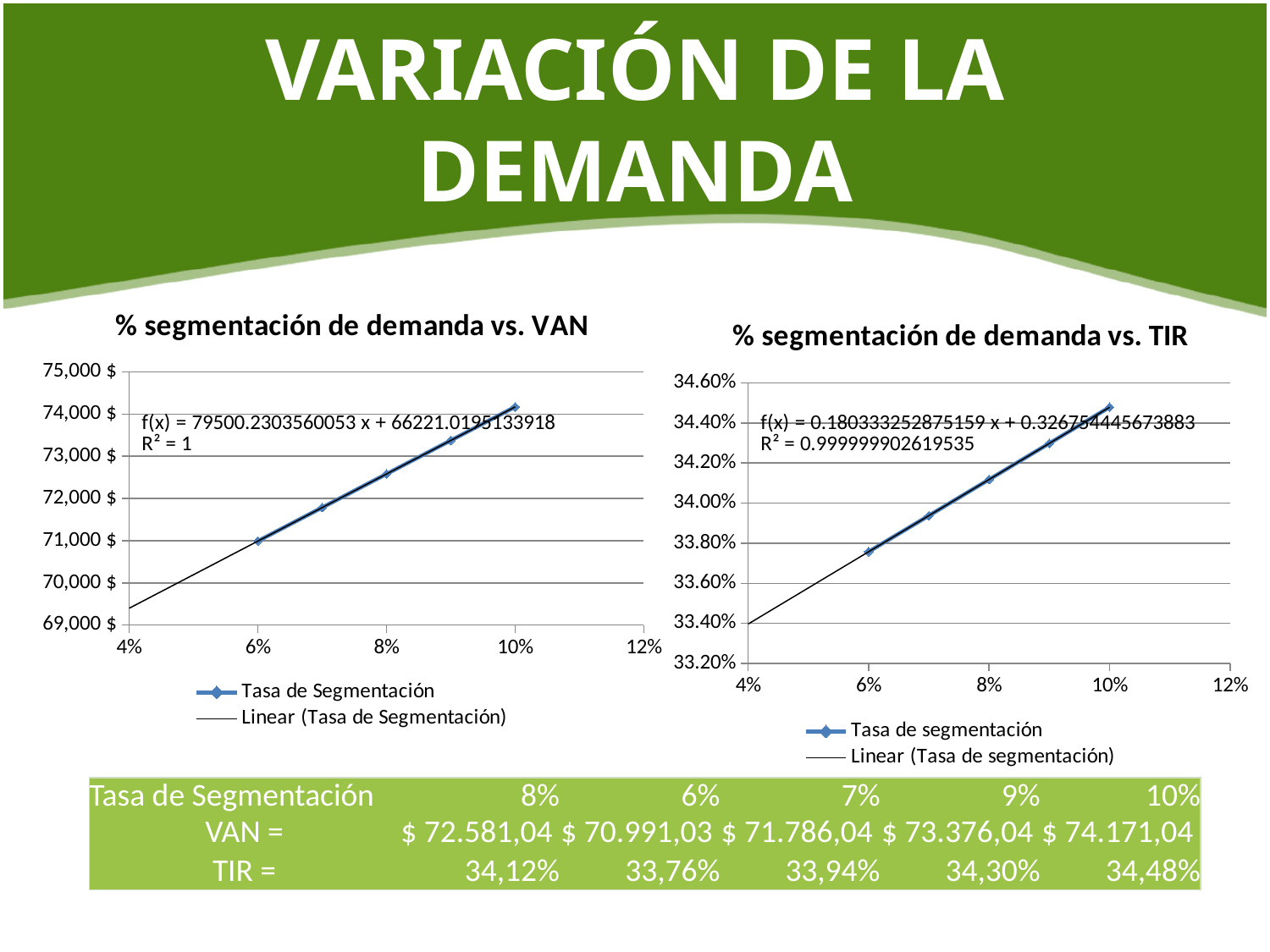
In the '% segmentación de demanda vs. VAN' chart, at which segmentation rate is the VAN highest? 10% In the '% segmentación de demanda vs. VAN' chart, is the value at 7% greater or less than 72,000 $? less In the '% segmentación de demanda vs. VAN' chart, is the value at 9% greater or less than 73,000 $? greater According to the table below the charts, what is the TIR for a Tasa de Segmentación of 10%? 34,48% In the '% segmentación de demanda vs. TIR' chart, at which segmentation rate is the TIR lowest? 6% In the '% segmentación de demanda vs. VAN' chart, do the values rise or fall as the segmentation rate increases along the x axis? rise What kind of chart is the '% segmentación de demanda vs. VAN' chart? line chart What R² value is shown on the '% segmentación de demanda vs. VAN' chart? R² = 1 How many entries does the legend of the '% segmentación de demanda vs. TIR' chart list? 2 In the '% segmentación de demanda vs. VAN' chart, how many data points are plotted for Tasa de Segmentación? 5 In the '% segmentación de demanda vs. TIR' chart, is the value at 8% greater or less than 34.00%? greater According to the table below the charts, what is the VAN for a Tasa de Segmentación of 8%? $ 72.581,04